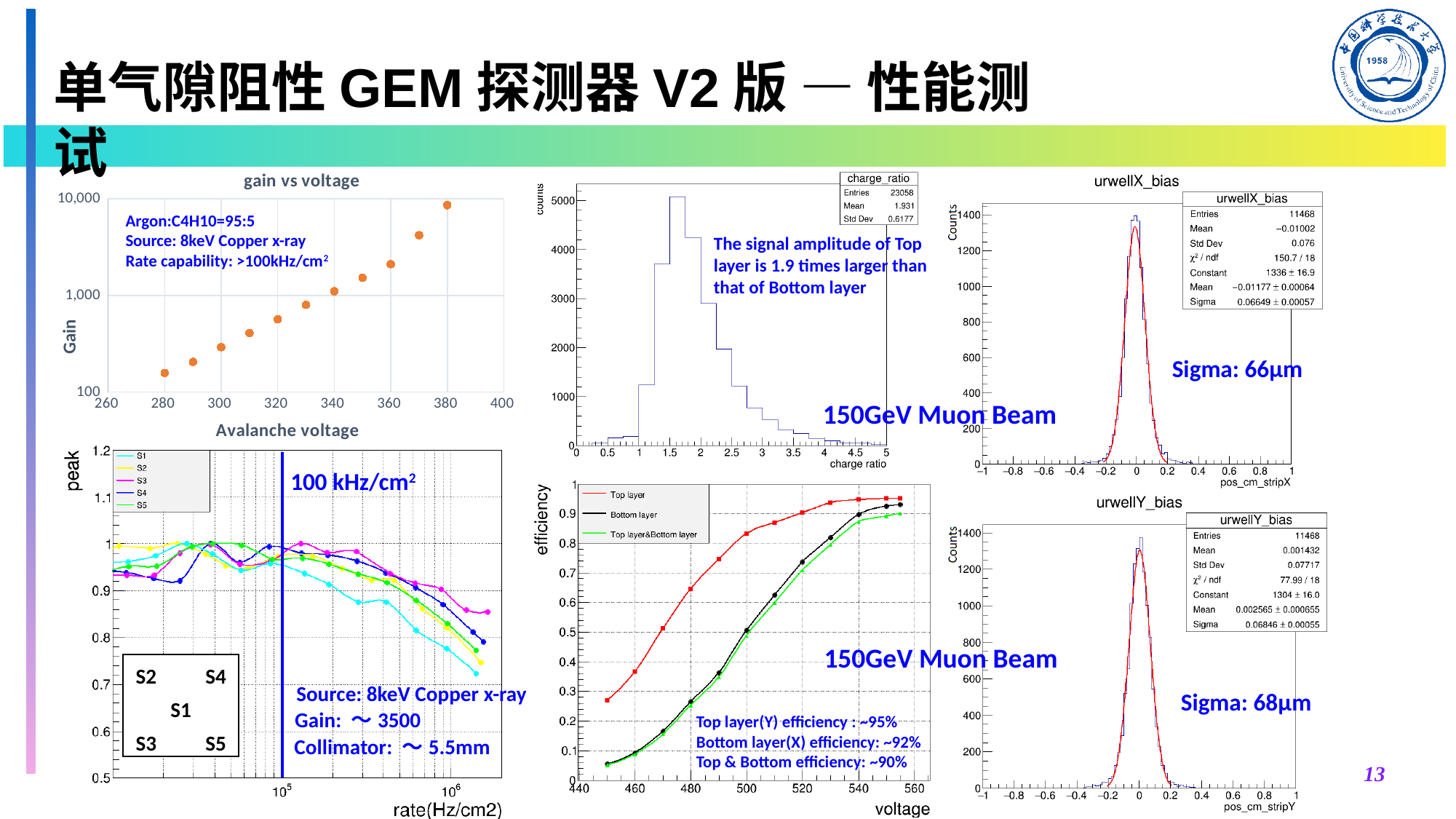
On the peak vs rate chart (bottom left), how many series does the legend list? 5 On the 'gain vs voltage' chart, how many data points are plotted? 11 On the efficiency vs voltage chart, which series has the highest efficiency at 450 V? Top layer On the 'gain vs voltage' chart, is the gain at 380 V greater or less than 1,000? greater On the efficiency vs voltage chart, is the Top layer efficiency at 500 V greater or less than 0.8? greater On the charge_ratio histogram, how many entries are listed in the statistics box? 23058 On the 'gain vs voltage' chart, does the gain rise or fall as the avalanche voltage increases? rise On the charge_ratio histogram, what is the Mean shown in the statistics box? 1.931 On the urwellX_bias histogram, what is the fitted Sigma shown in the statistics box? 0.06649 ± 0.00057 On the efficiency vs voltage chart, how many series does the legend list? 3 On the 'gain vs voltage' chart, what kind of chart is it? scatter chart Which histogram has the larger Std Dev in its statistics box, urwellX_bias or urwellY_bias? urwellY_bias